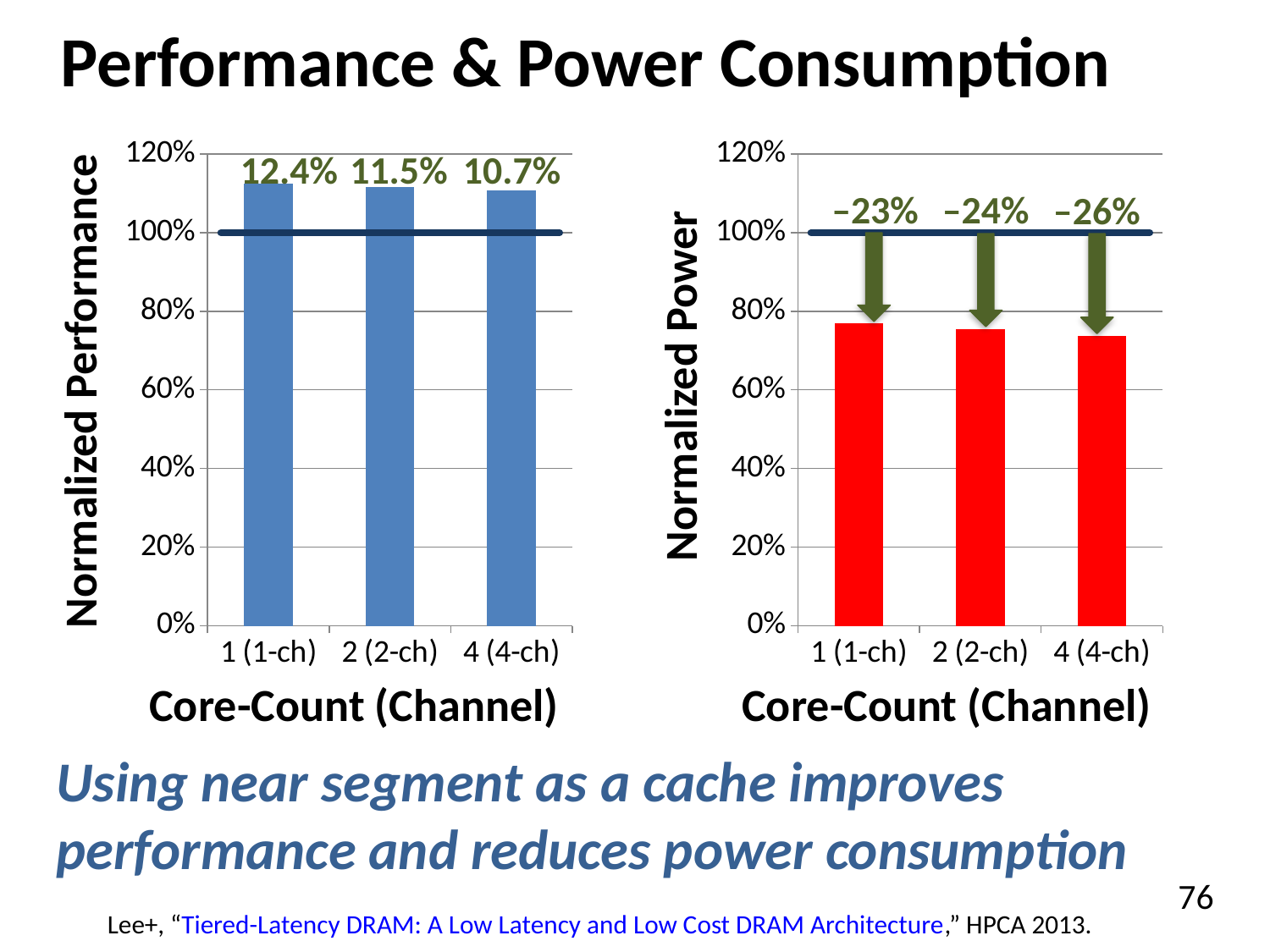
On the Normalized Performance chart (left), is the bar for 2 (2-ch) greater or less than 100%? greater What kind of chart is the Normalized Performance chart (left)? Bar chart How many core-count categories are shown on the Normalized Power chart (right)? 3 On the Normalized Power chart (right), which core-count category has the largest printed power reduction? 4 (4-ch) On the Normalized Performance chart (left), what is the difference between the printed labels for 1 (1-ch) and 4 (4-ch)? 1.7 percentage points On the Normalized Power chart (right), is the bar for 1 (1-ch) greater or less than 80%? less On the Normalized Power chart (right), what percentage label is printed above the 4 (4-ch) bar? –26% On the Normalized Power chart (right), what percentage label is printed above the 2 (2-ch) bar? –24% On the Normalized Performance chart (left), which core-count category has the largest printed improvement label? 1 (1-ch) On the Normalized Performance chart (left), what percentage label is printed above the 4 (4-ch) bar? 10.7% On the Normalized Performance chart (left), do the bar heights rise or fall as the core count increases from 1 (1-ch) to 4 (4-ch)? Fall On the Normalized Performance chart (left), what percentage label is printed above the 1 (1-ch) bar? 12.4%